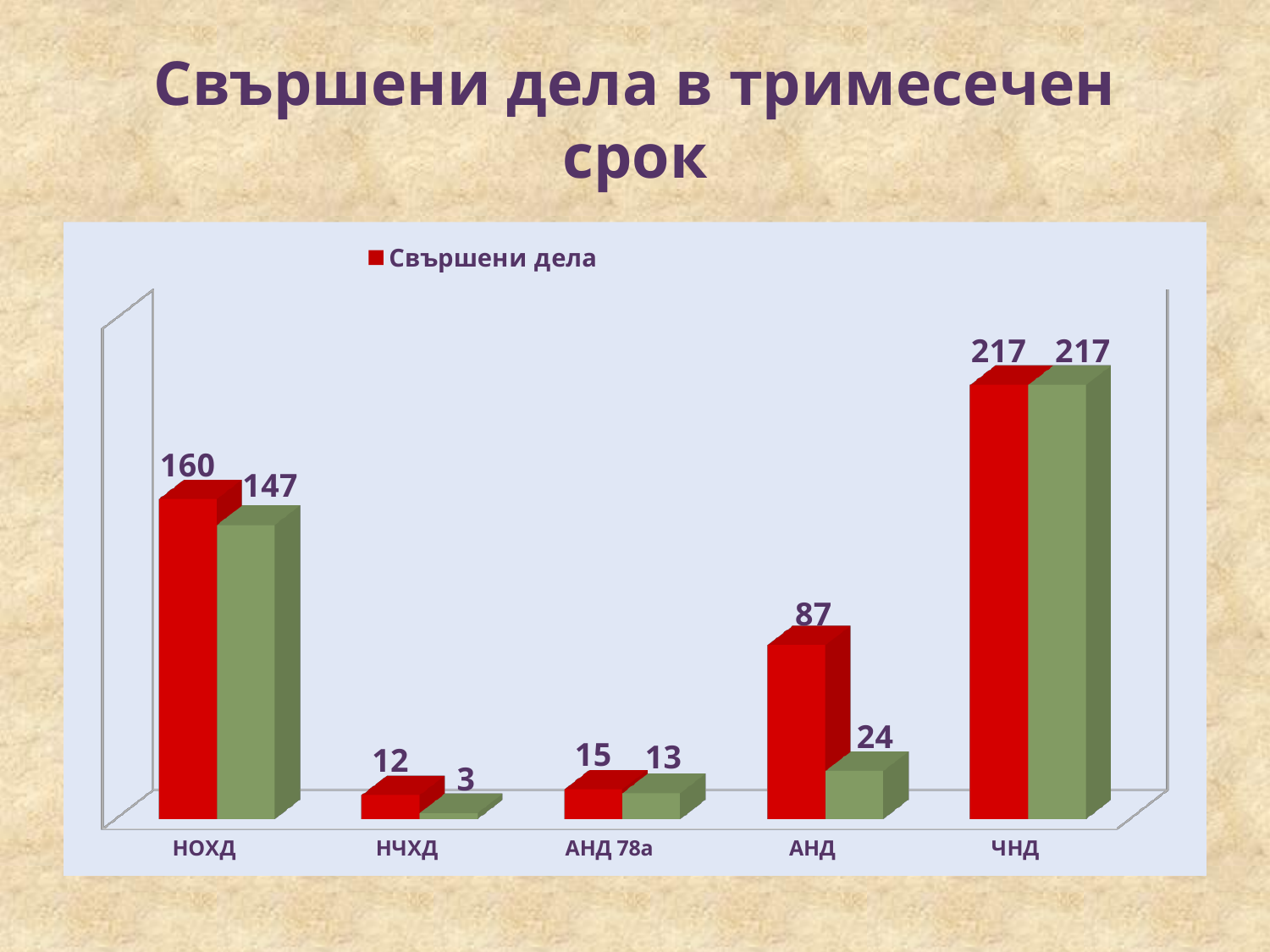
What is the value of the red 'Свършени дела' bar for НОХД? 160 What is the value of the green bar for НЧХД? 3 What type of chart is shown on the slide? bar chart What is the difference between the red and green bars for НОХД? 13 What is the value of the red 'Свършени дела' bar for АНД? 87 What is the title of the slide? Свършени дела в тримесечен срок Which category has the highest value for the red 'Свършени дела' series? ЧНД Which is larger for АНД 78а, the red bar or the green bar? the red bar What is the value of the green bar for АНД 78а? 13 What is the difference between the red and green bars for АНД? 63 Which category has the lowest value for the green series? НЧХД How many categories are shown on the x axis? 5